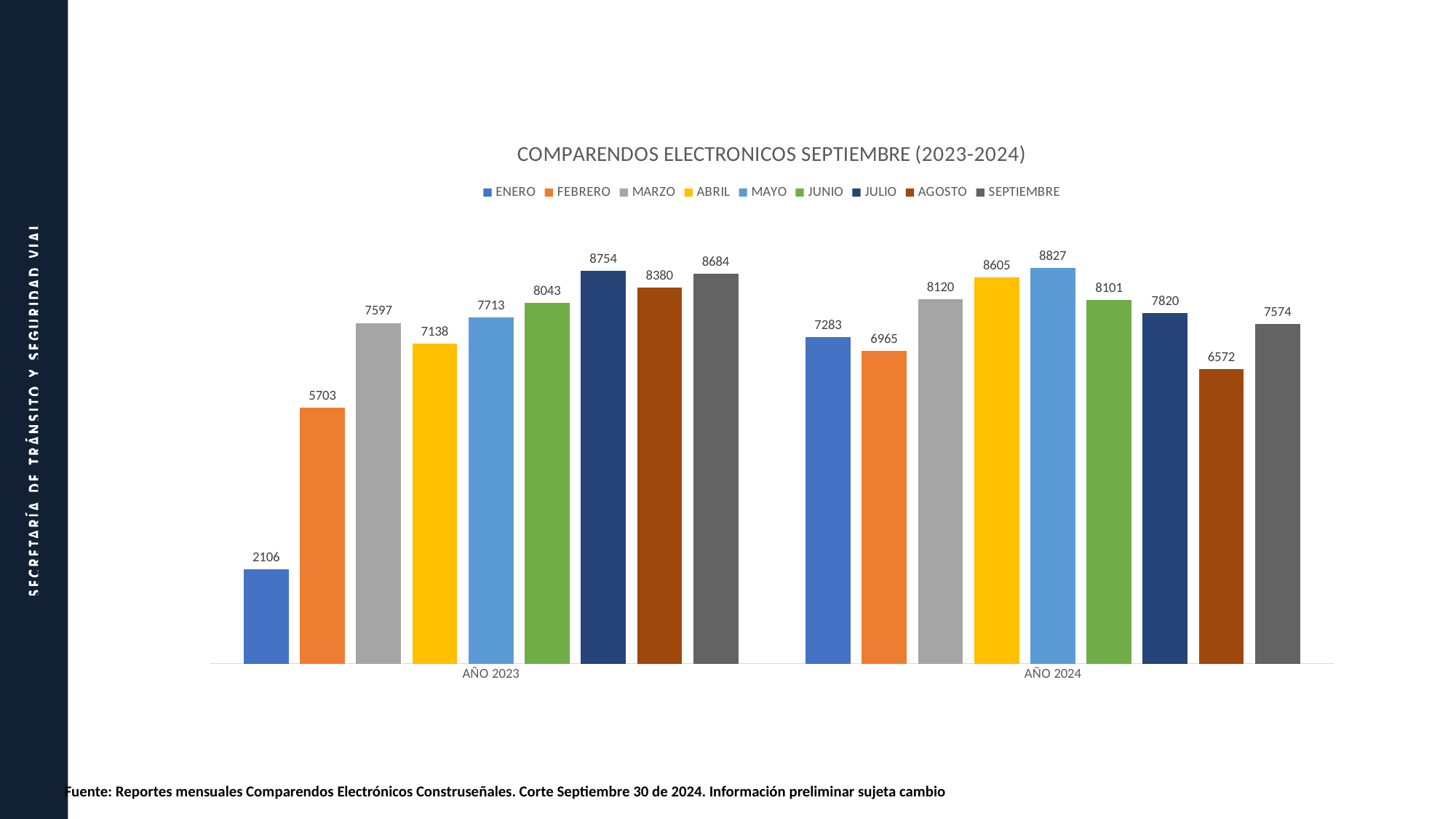
What is the value for AGOSTO in AÑO 2023? 8380 Which month has the lowest value in AÑO 2023? ENERO Which is larger, the JULIO value in AÑO 2023 or the JULIO value in AÑO 2024? AÑO 2023 Which month has the lowest value in AÑO 2024? AGOSTO What is the value for SEPTIEMBRE in AÑO 2024? 7574 How many year categories are shown on the x axis? 2 Which month has the highest value in AÑO 2024? MAYO What is the difference between the ENERO values for AÑO 2024 and AÑO 2023? 5177 What is the title of the chart? COMPARENDOS ELECTRONICOS SEPTIEMBRE (2023-2024) How many series does the legend list? 9 What kind of chart is shown on the slide? Bar chart What is the value for ENERO in AÑO 2023? 2106